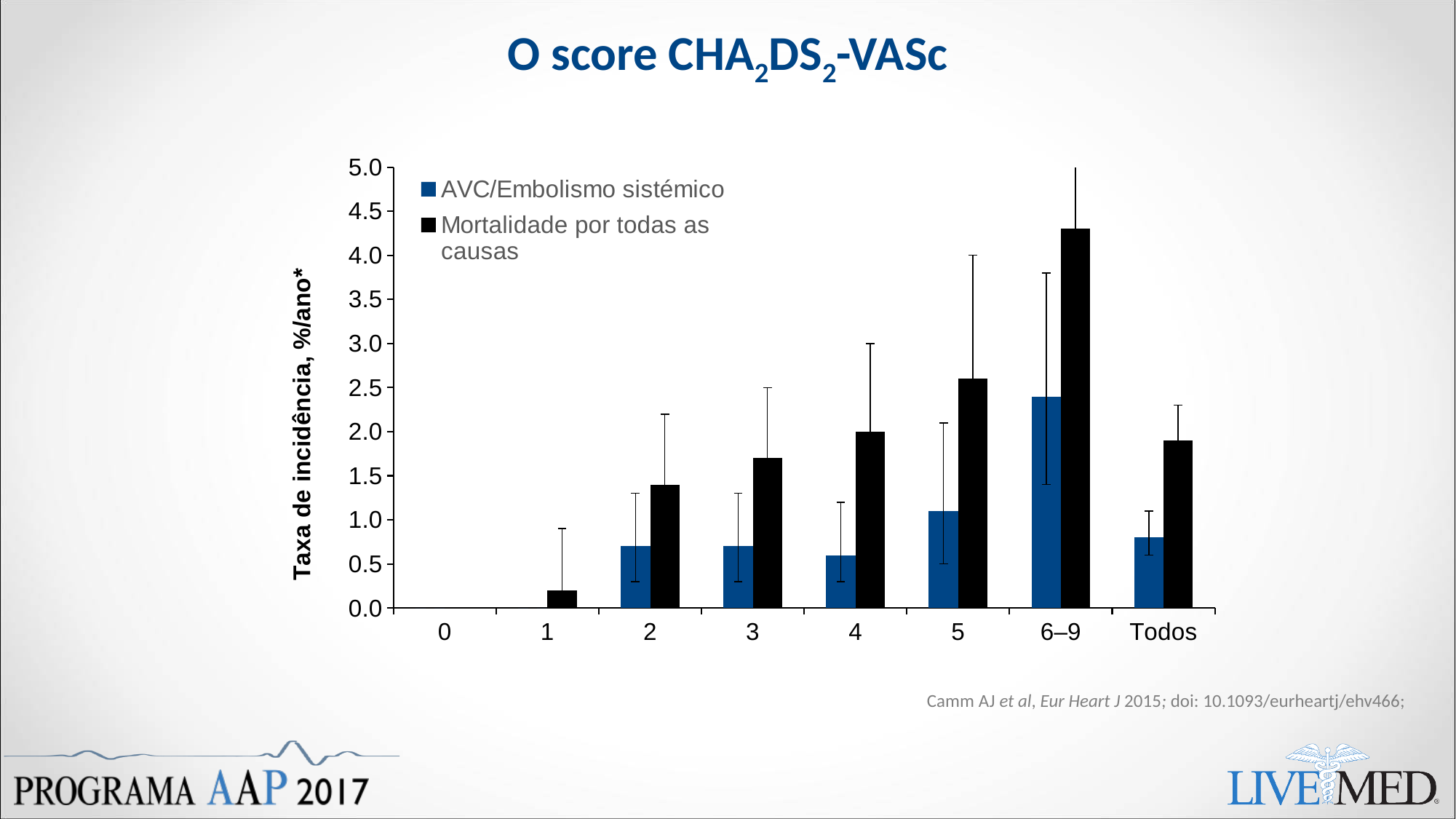
What is the label of the y axis? Taxa de incidência, %/ano* Does the value for Mortalidade por todas as causas rise or fall from score 1 to score 6–9? rise Which category has the highest value for Mortalidade por todas as causas? 6–9 What kind of chart is shown on the slide? bar chart Is the value for AVC/Embolismo sistémico for Todos greater or less than 1.0? less How many categories are shown on the x axis? 8 Is the value for AVC/Embolismo sistémico at score 6–9 greater or less than 2.0? greater How many series does the legend list? 2 Which category has the highest value for AVC/Embolismo sistémico? 6–9 Is the value for Mortalidade por todas as causas at score 6–9 greater or less than 4.0? greater For the Todos category, which series has the larger value: AVC/Embolismo sistémico or Mortalidade por todas as causas? Mortalidade por todas as causas